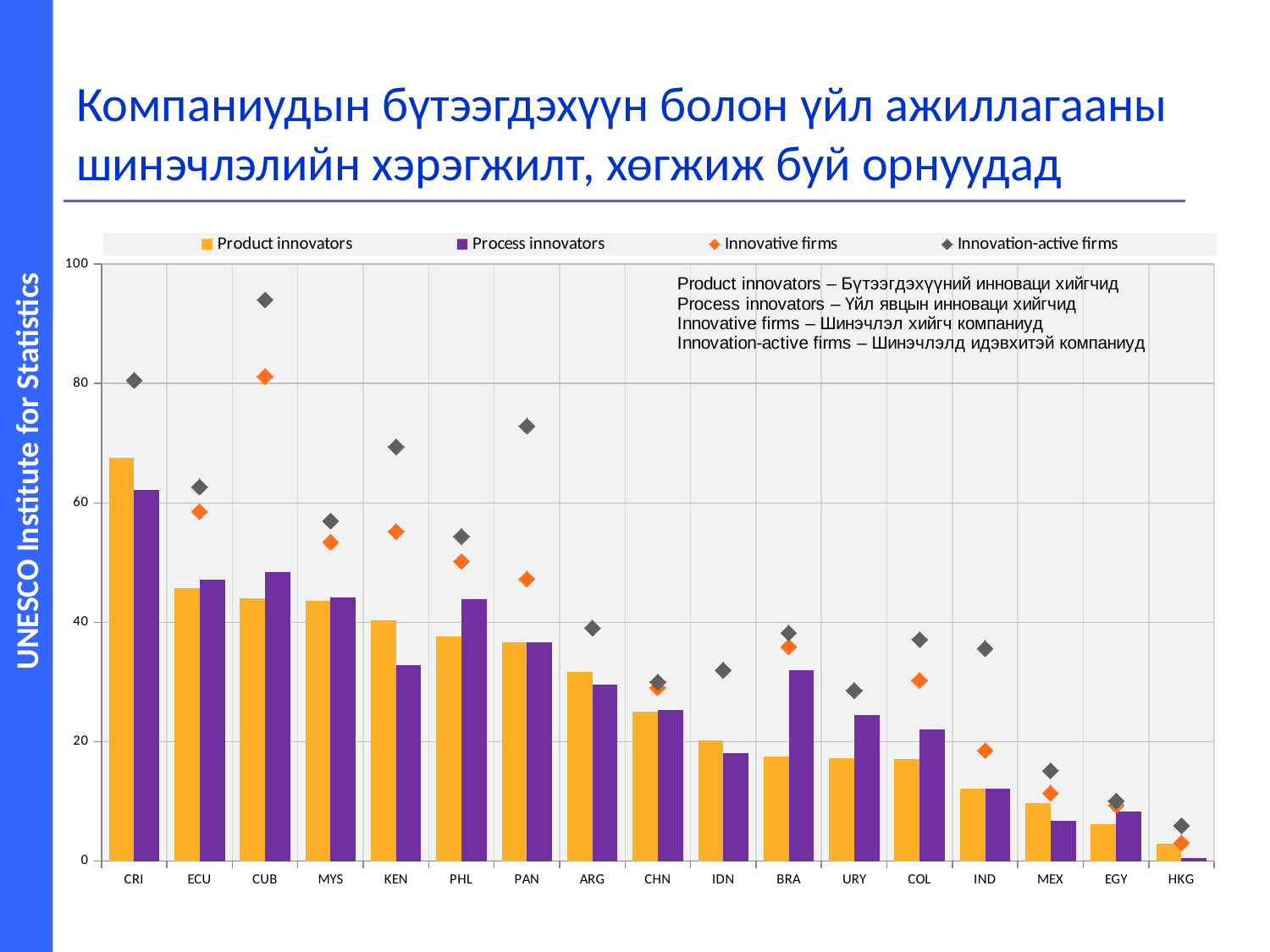
Which country has the highest Innovation-active firms value? CUB For BRA, which is larger: Product innovators or Process innovators? Process innovators Do the Product innovators values generally rise or fall from left to right across the x axis? fall Is the Innovation-active firms value for CUB greater or less than 80? greater What colour are the Process innovators bars? purple Is the Product innovators value for CRI greater or less than 60? greater Which country has the lowest Product innovators value? HKG How many series does the chart legend list? 4 Which country has the highest Product innovators value? CRI Is the Process innovators value for BRA greater or less than 20? greater Which country has the highest Innovative firms value? CUB How many countries are shown on the x axis of the chart? 17